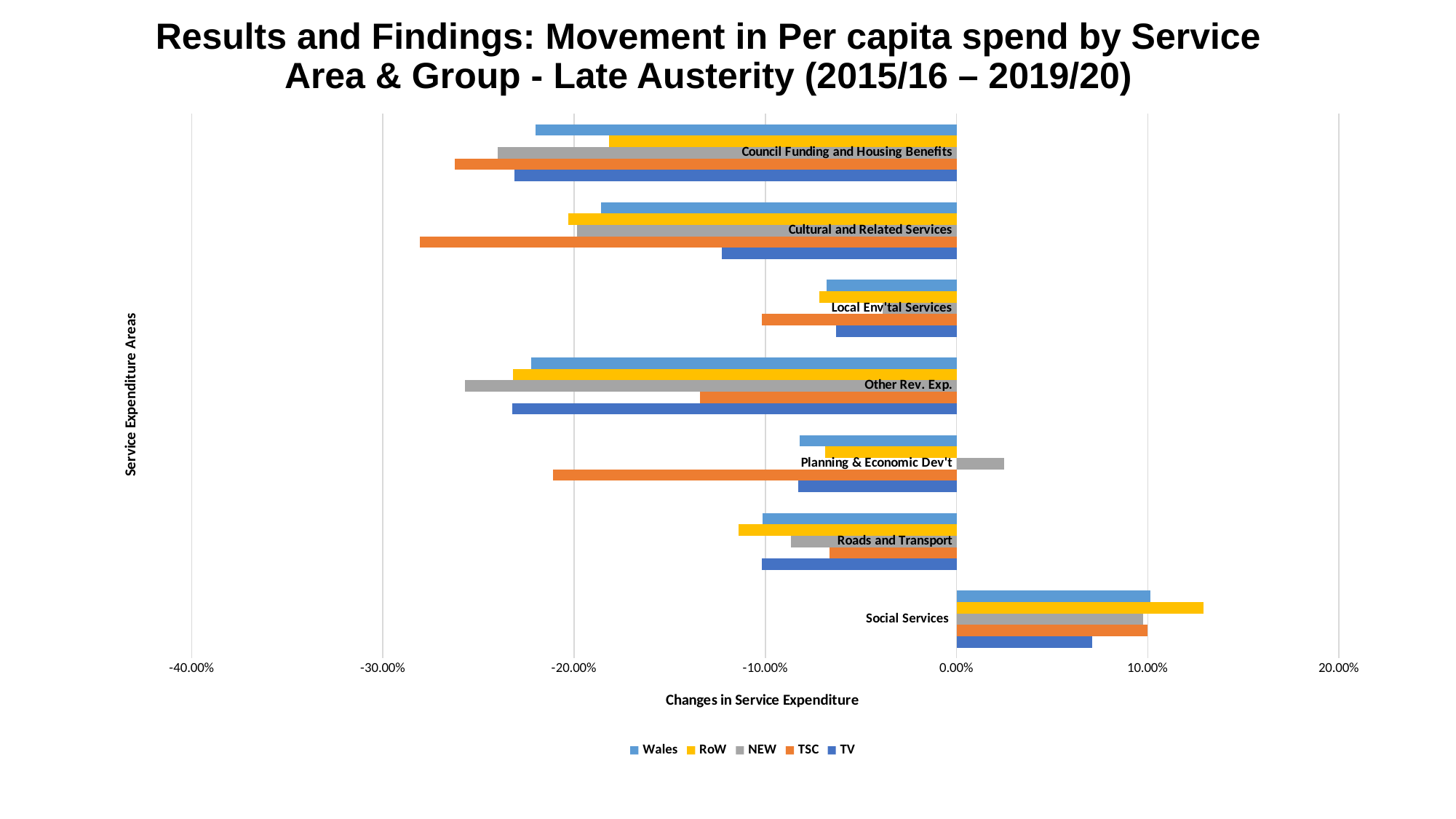
How many service expenditure areas are plotted on the chart? 7 What is the label of the horizontal axis? Changes in Service Expenditure Is the value for Wales in Local Env'tal Services greater or less than -10.00%? greater For Planning & Economic Dev't, which group is the only one with a positive change? NEW How many series does the legend list? 5 For Social Services, which group has the highest change in service expenditure? RoW For Social Services, which is larger: the value for RoW or the value for TV? RoW Is the value for TSC in Cultural and Related Services greater or less than -20.00%? less Which service expenditure area is the only one where all groups show a positive change? Social Services What kind of chart is shown on the slide? bar chart For Cultural and Related Services, which group has the lowest (most negative) change? TSC Is the value for RoW in Social Services greater or less than 10.00%? greater